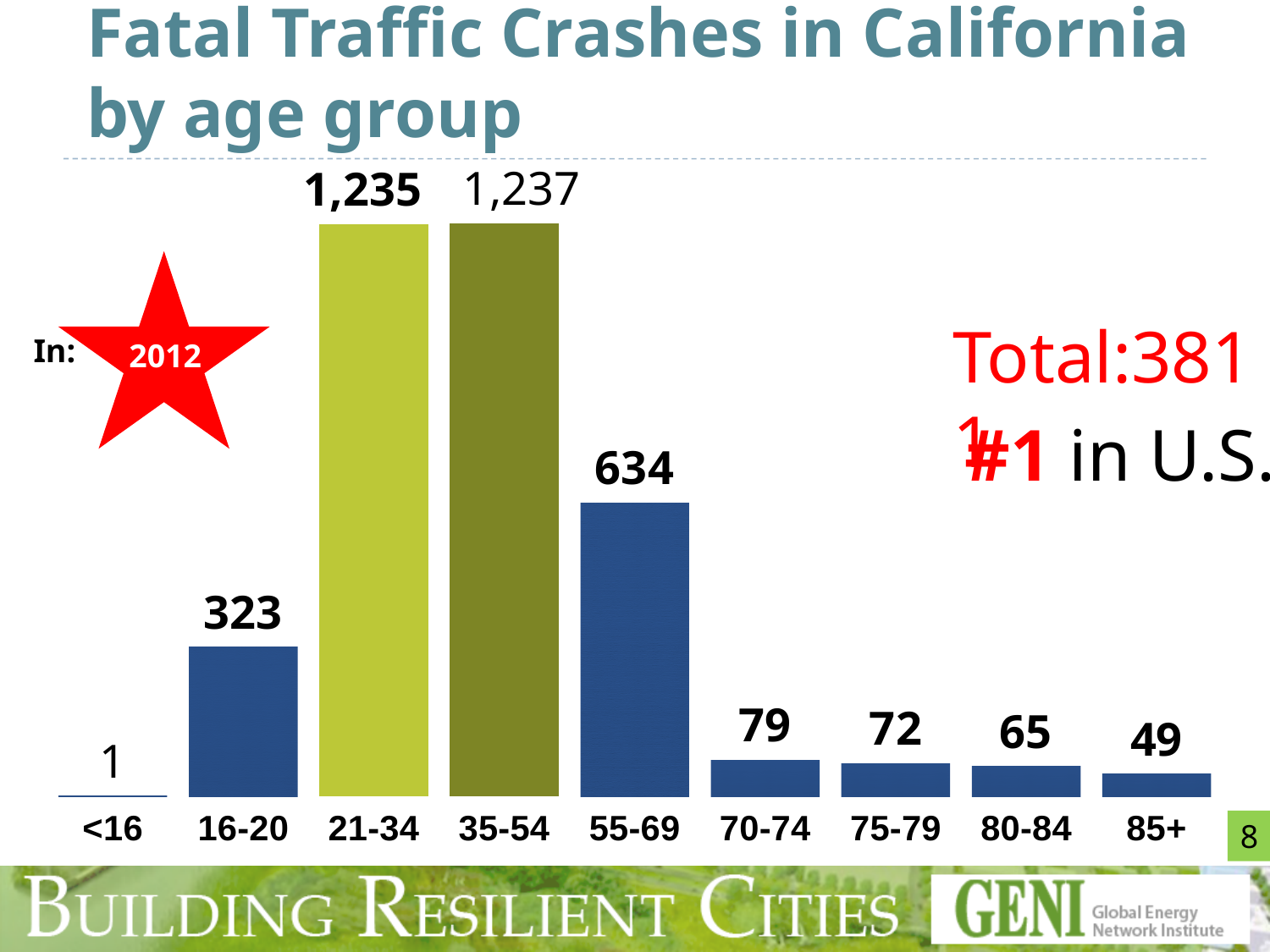
What kind of chart is shown on the slide? Bar chart What is the number of fatal traffic crashes for the 16-20 age group? 323 Do the values rise or fall from the 55-69 age group to the 85+ age group? Fall How many age groups are shown on the x axis? 9 What is the value shown for the 55-69 age group? 634 What is the value shown for the 85+ age group? 49 What is the difference between the values for the 70-74 and 75-79 age groups? 7 Which age group has the highest number of fatal traffic crashes? 35-54 Which age group has the lowest number of fatal traffic crashes? <16 What is the value shown for the 21-34 age group? 1,235 What is the difference between the values for the 55-69 and 16-20 age groups? 311 Which age group has a larger value, 16-20 or 55-69? 55-69